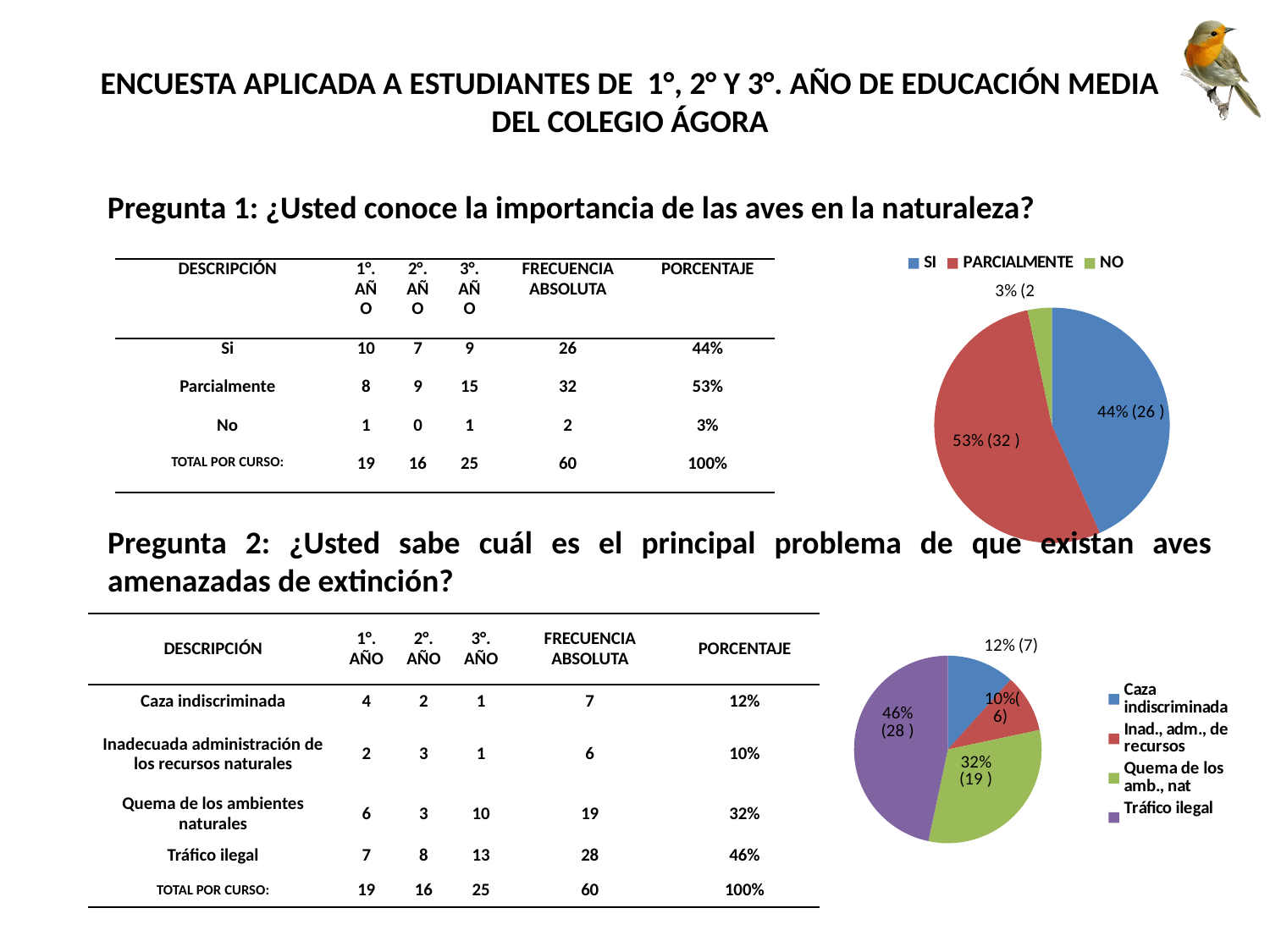
What type of chart is used for Pregunta 1 on the right of the slide? Pie chart In the top pie chart (Pregunta 1), which category has the smallest slice? NO In the bottom pie chart (Pregunta 2), how many categories does the legend list? 4 In the bottom pie chart (Pregunta 2), what percentage is shown for Quema de los amb., nat? 32% In the top pie chart (Pregunta 1), what percentage is shown for the PARCIALMENTE slice? 53% In the bottom pie chart (Pregunta 2), what percentage is shown for Tráfico ilegal? 46% In the top pie chart (Pregunta 1), what percentage is shown for the SI slice? 44% In the top pie chart (Pregunta 1), what is the difference in percentage points between the PARCIALMENTE and SI slices? 9 In the top pie chart (Pregunta 1), which category has the largest slice? PARCIALMENTE In the bottom pie chart (Pregunta 2), which is larger: Caza indiscriminada or Inad., adm., de recursos? Caza indiscriminada In the top pie chart (Pregunta 1), how many categories does the legend list? 3 In the bottom pie chart (Pregunta 2), which category has the largest slice? Tráfico ilegal